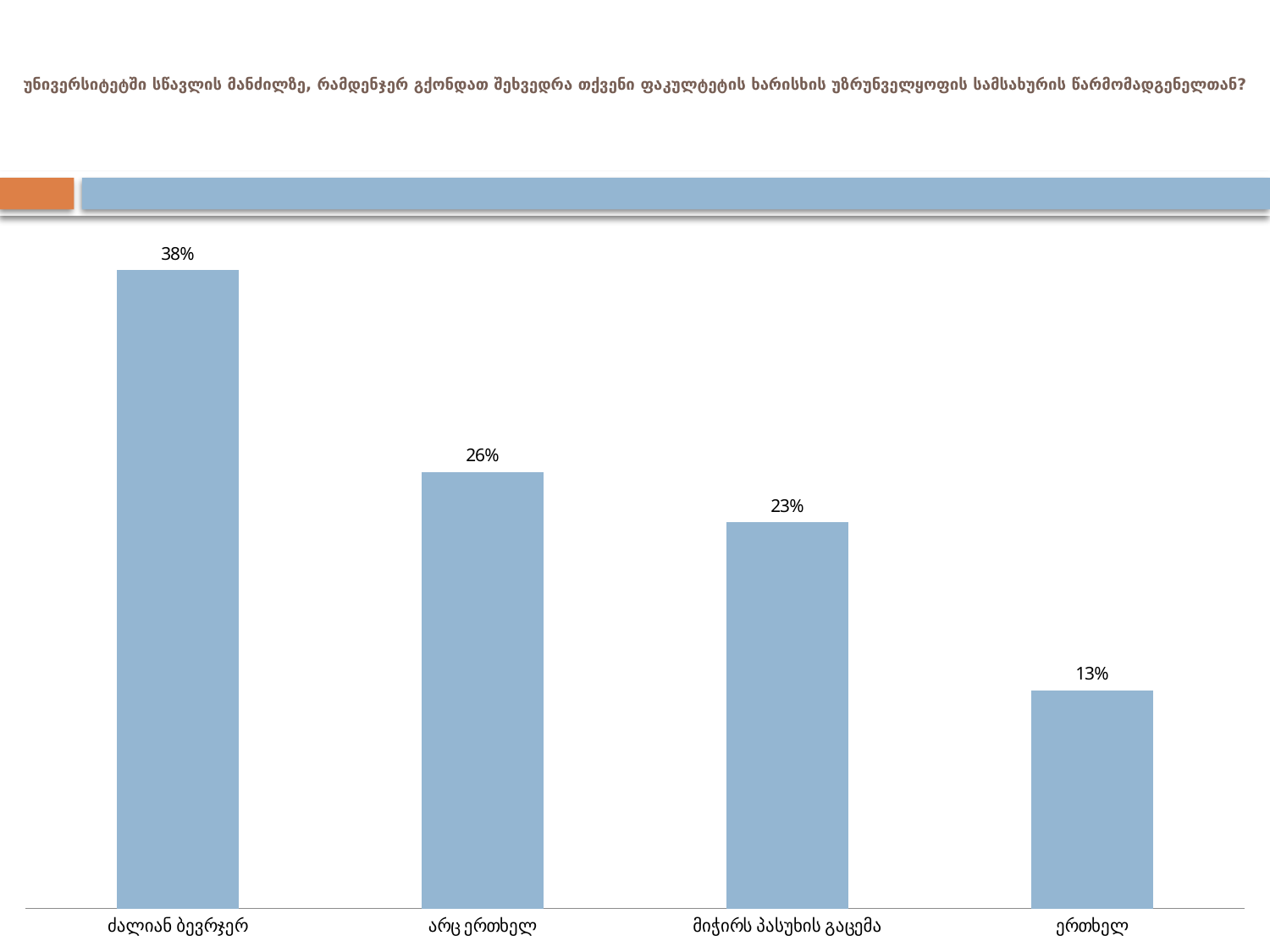
How many categories are shown in the chart? 4 Which category has the lowest value? ერთხელ Do the values rise or fall from left to right along the x axis? fall What is the value for არც ერთხელ? 26% What is the value for ერთხელ? 13% What is the value for ძალიან ბევრჯერ? 38% What is the difference between the values for ძალიან ბევრჯერ and ერთხელ? 25% What is the difference between the values for არც ერთხელ and მიჭირს პასუხის გაცემა? 3% What is the value for მიჭირს პასუხის გაცემა? 23% Which is larger, the value for არც ერთხელ or the value for ერთხელ? არც ერთხელ What kind of chart is shown on the slide? bar chart Which category has the highest value? ძალიან ბევრჯერ